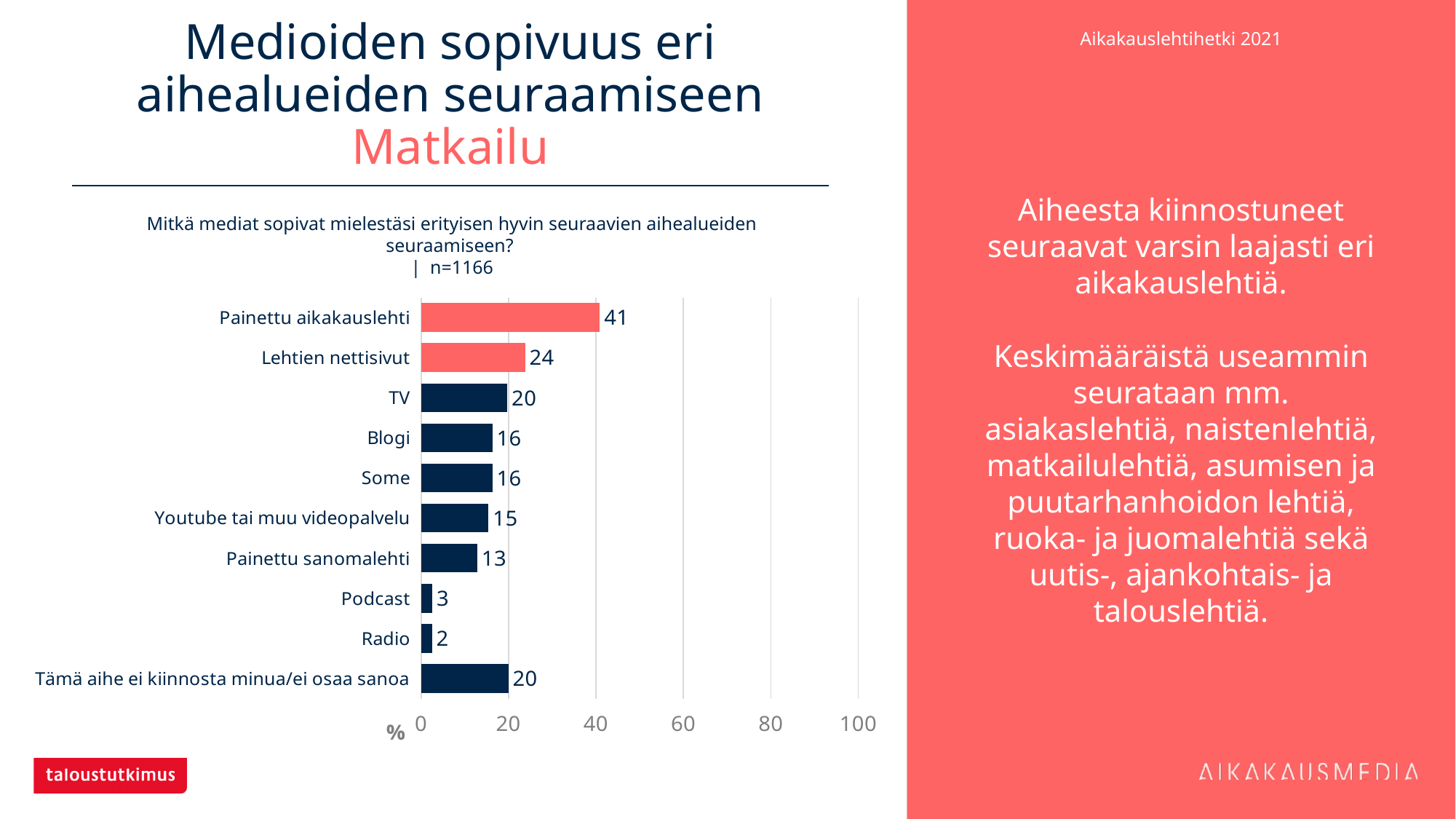
Which category has the lowest value? Radio What is the sample size (n) stated above the chart? n=1166 What is the value for Painettu aikakauslehti? 41 What is the value for Tämä aihe ei kiinnosta minua/ei osaa sanoa? 20 What is the value for Painettu sanomalehti? 13 What kind of chart is shown on the slide? Bar chart How many categories are shown in the chart? 10 Which category has the highest value? Painettu aikakauslehti What is the value for Lehtien nettisivut? 24 Is the value for Painettu aikakauslehti greater or less than 40? greater Which has a larger value, TV or Youtube tai muu videopalvelu? TV What is the difference between the values for Painettu aikakauslehti and Lehtien nettisivut? 17